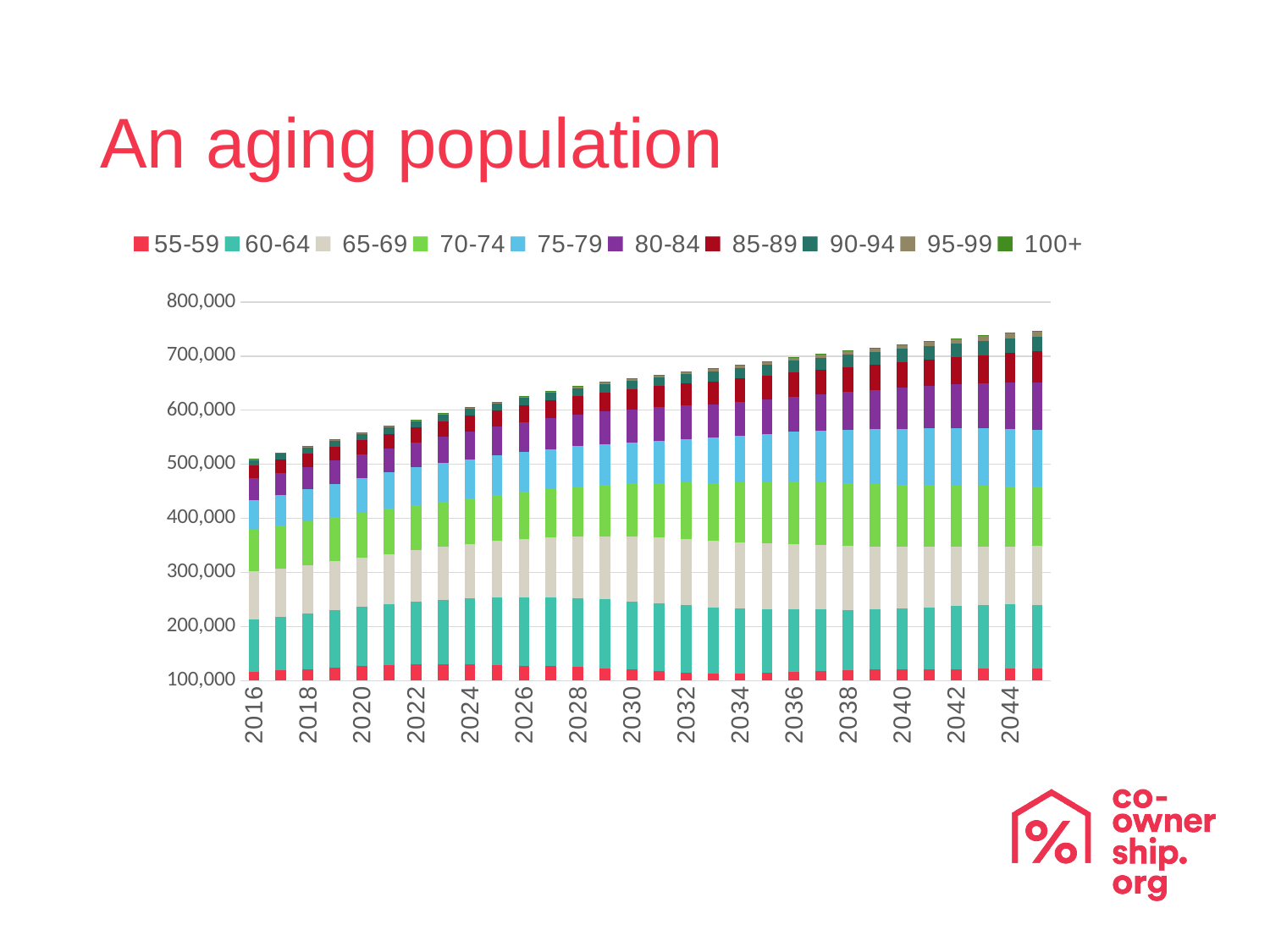
Which year has the tallest stacked bar? 2045 What kind of chart is shown on the slide? stacked bar chart Do the total bar heights rise or fall from 2016 to 2045? rise Is the total for 2022 greater or less than 600,000? less What is the title of the slide above the chart? An aging population How many years (bars) are plotted on the chart? 30 Is the total for 2045 greater or less than 700,000? greater Which year has the larger total, 2016 or 2045? 2045 Is the total for 2030 greater or less than 700,000? less How many series does the legend list? 10 Which year has the shortest stacked bar? 2016